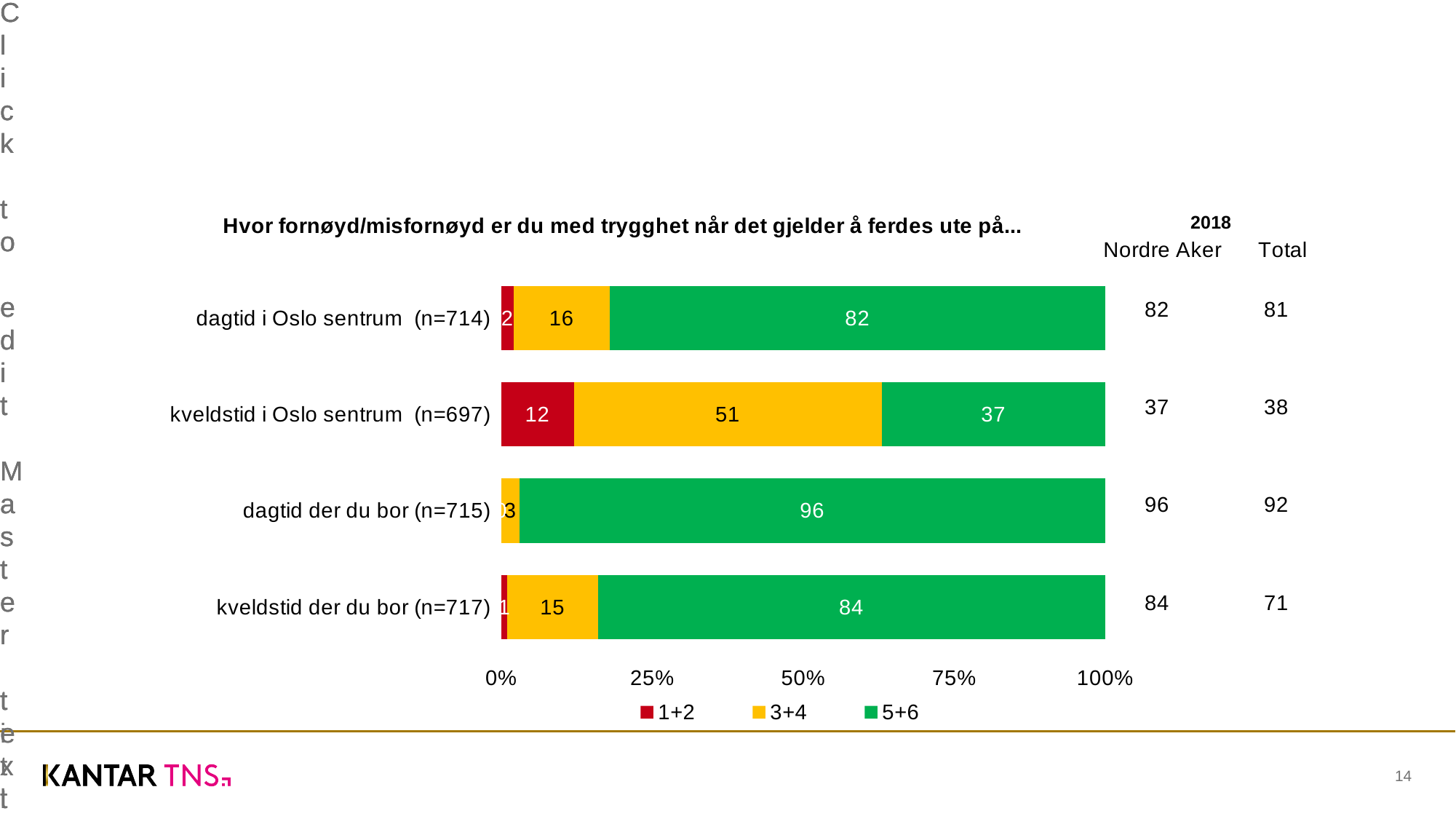
What is the value of the 5+6 series for 'dagtid der du bor (n=715)'? 96 What is the value of the 5+6 series for 'kveldstid i Oslo sentrum (n=697)'? 37 Which legend entry is shown in green? 5+6 What is the value of the 1+2 series for 'kveldstid i Oslo sentrum (n=697)'? 12 Which is larger: the 3+4 value for 'kveldstid i Oslo sentrum (n=697)' or the 3+4 value for 'kveldstid der du bor (n=717)'? kveldstid i Oslo sentrum (n=697) Which category has the lowest value for the 5+6 series? kveldstid i Oslo sentrum (n=697) What is the value of the 3+4 series for 'dagtid i Oslo sentrum (n=714)'? 16 How many series does the legend list? 3 What kind of chart is shown on the slide? stacked bar chart Which category has the highest value for the 5+6 series? dagtid der du bor (n=715) What is the difference between the 5+6 values for 'kveldstid der du bor (n=717)' and 'kveldstid i Oslo sentrum (n=697)'? 47 How many categories are plotted on the chart? 4